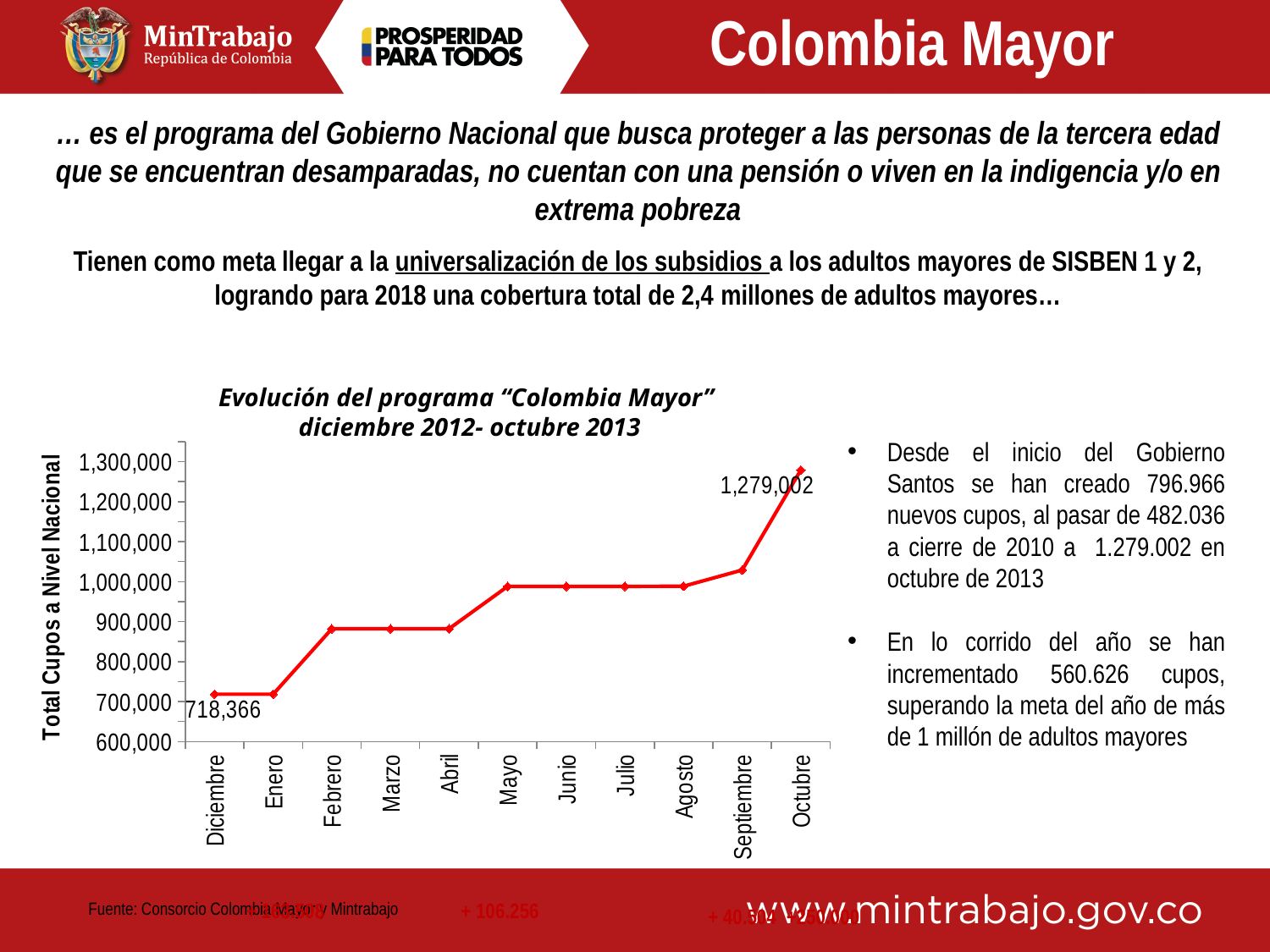
How many months are plotted along the x axis of the chart? 11 Which month has the highest value in the chart? Octubre What is the difference between the values for Octubre and Diciembre? 560,636 What kind of chart is shown on the slide? line chart What is the label of the vertical axis of the chart? Total Cupos a Nivel Nacional Which is larger, the value for Febrero or the value for Mayo? Mayo Is the value for Febrero greater or less than 800,000? greater What is the value for Diciembre in the chart? 718,366 Is the value for Enero greater or less than 800,000? less Is the value for Septiembre greater or less than 1,000,000? greater What is the title of the chart? Evolución del programa "Colombia Mayor" diciembre 2012- octubre 2013 What is the value for Octubre in the chart? 1,279,002